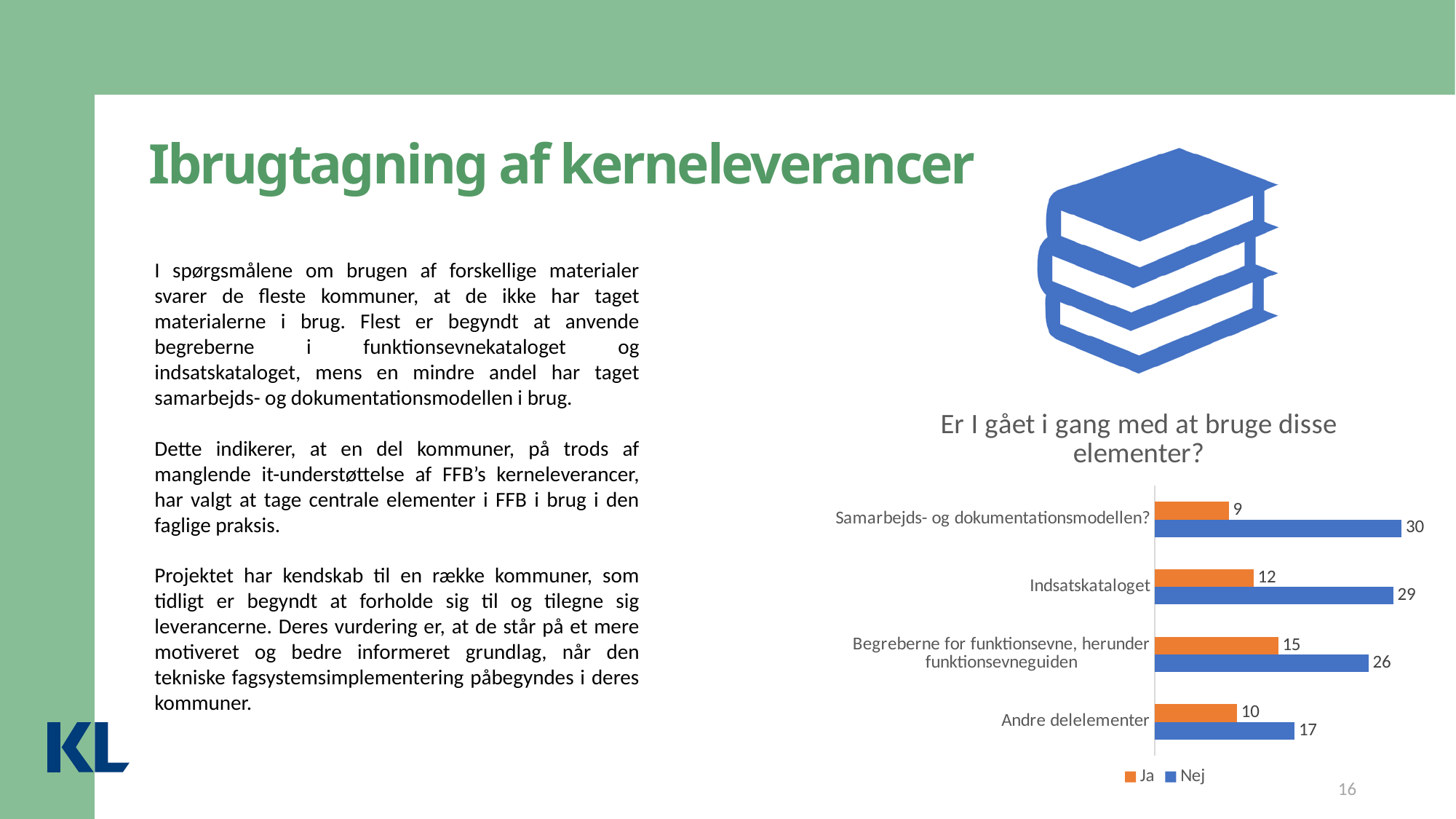
What is the 'Ja' value for Indsatskataloget? 12 Which is larger for Indsatskataloget, the 'Ja' value or the 'Nej' value? Nej What is the 'Nej' value for Andre delelementer? 17 How many categories are shown in the chart? 4 Which category has the highest 'Ja' value? Begreberne for funktionsevne, herunder funktionsevneguiden What is the title of the chart? Er I gået i gang med at bruge disse elementer? Which category has the lowest 'Nej' value? Andre delelementer How many series does the legend list? 2 What is the total of the 'Ja' and 'Nej' values for Andre delelementer? 27 What kind of chart is shown on the slide? Bar chart What is the difference between the 'Nej' and 'Ja' values for Samarbejds- og dokumentationsmodellen? 21 What is the 'Nej' value for Samarbejds- og dokumentationsmodellen? 30